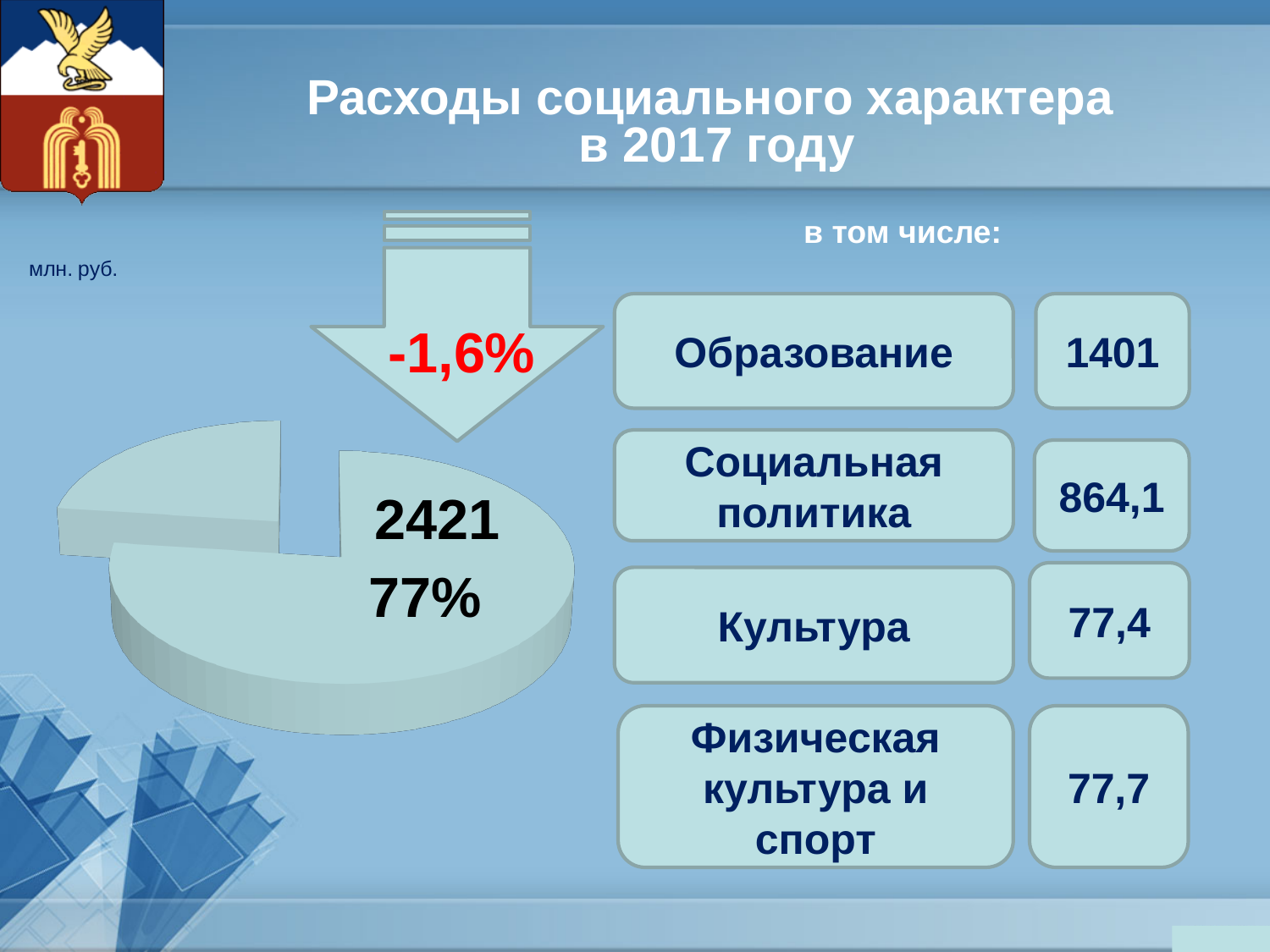
What is the value shown for Образование in the breakdown? 1401 What is the value shown for Культура in the breakdown? 77,4 Which category in the breakdown has the highest value? Образование What percentage change is shown in the arrow above the pie chart? -1,6% What unit is indicated for the values on the slide? млн. руб. Which is larger in the breakdown: Культура or Физическая культура и спорт? Физическая культура и спорт What value is printed on the large slice of the pie chart? 2421 What is the value shown for Социальная политика in the breakdown? 864,1 What share of the pie does the large labelled slice represent? 77% What is the title of the slide? Расходы социального характера в 2017 году How many categories are listed in the breakdown on the right of the slide? 4 What kind of chart is shown on the slide? pie chart